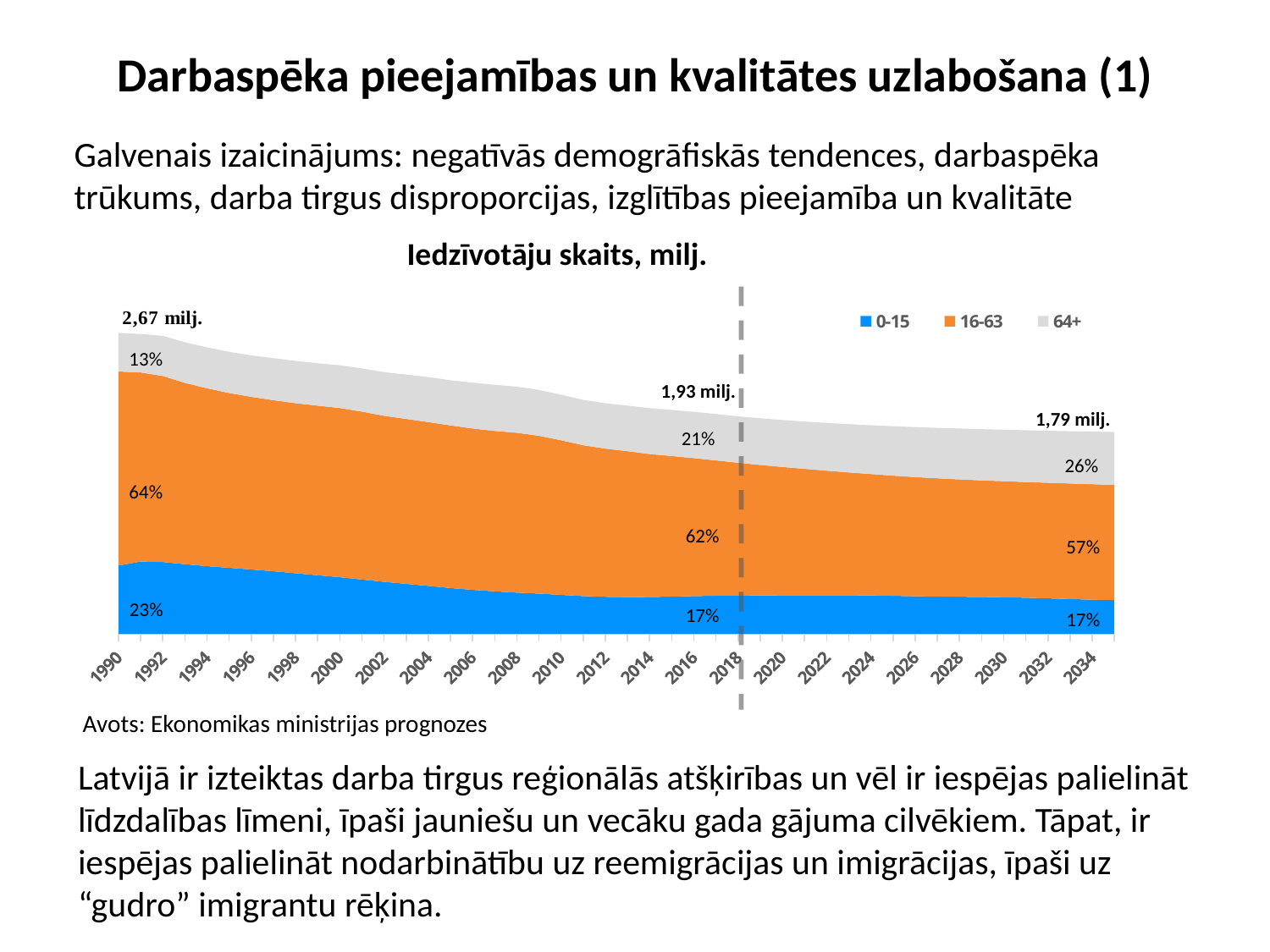
Which is larger at 2018: the 64+ share or the 0-15 share? 64+ share (21%) Does the total population rise or fall along the x axis from 1990 to 2034? fall What is the title of the chart? Iedzīvotāju skaits, milj. By how many percentage points does the 64+ share change from 1990 (13%) to the right end of the chart (26%)? 13 percentage points What share of the population is the 16-63 group at 2018? 62% What share of the population is the 0-15 group at the right end of the chart? 17% What total population in millions is labelled at the start of the chart in 1990? 2,67 milj. What total population in millions is labelled at 2018? 1,93 milj. What total population in millions is labelled at the right end of the chart? 1,79 milj. How many series does the chart legend list? 3 What share of the population is the 64+ group in 1990? 13% What kind of chart is shown on the slide? stacked area chart